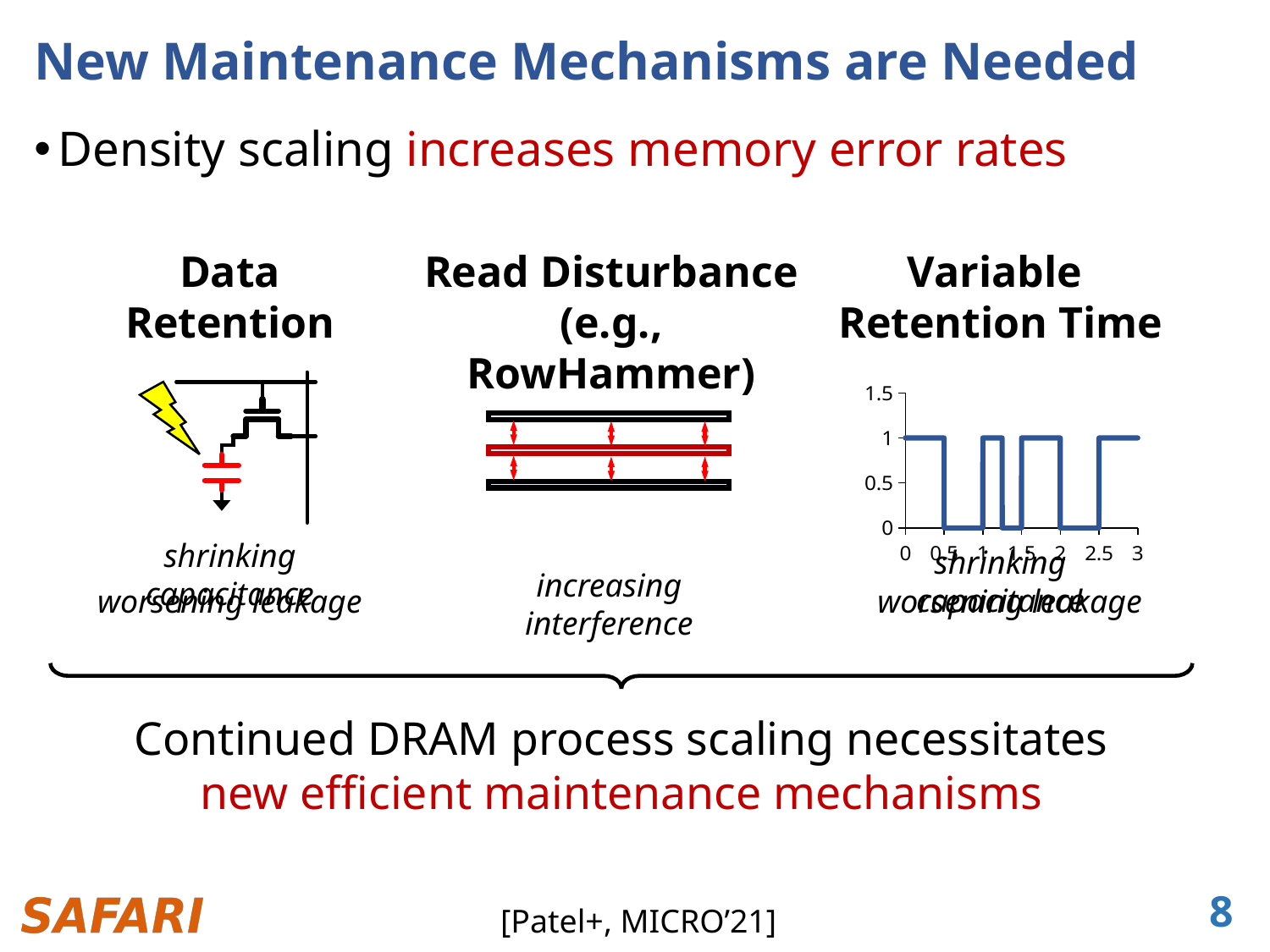
In the Variable Retention Time chart, what is the value of the line at x = 0? 1 What is the highest tick label on the x axis of the Variable Retention Time chart? 3 In the Variable Retention Time chart, what is the value of the line at x = 3? 1 In the Variable Retention Time chart, what is the lowest value the line reaches? 0 In the Variable Retention Time chart, is the value of the line at x = 0.75 greater or less than 0.5? less In the Variable Retention Time chart, what is the highest value the line reaches? 1 What is the highest tick label on the y axis of the Variable Retention Time chart? 1.5 In the Variable Retention Time chart, is the value of the line at x = 2.25 greater or less than 0.5? less What kind of chart is shown under the heading "Variable Retention Time"? line chart In the Variable Retention Time chart, which is larger: the value of the line at x = 0 or at x = 0.75? x = 0 In the Variable Retention Time chart, is the value of the line at x = 1.75 greater or less than 0.5? greater